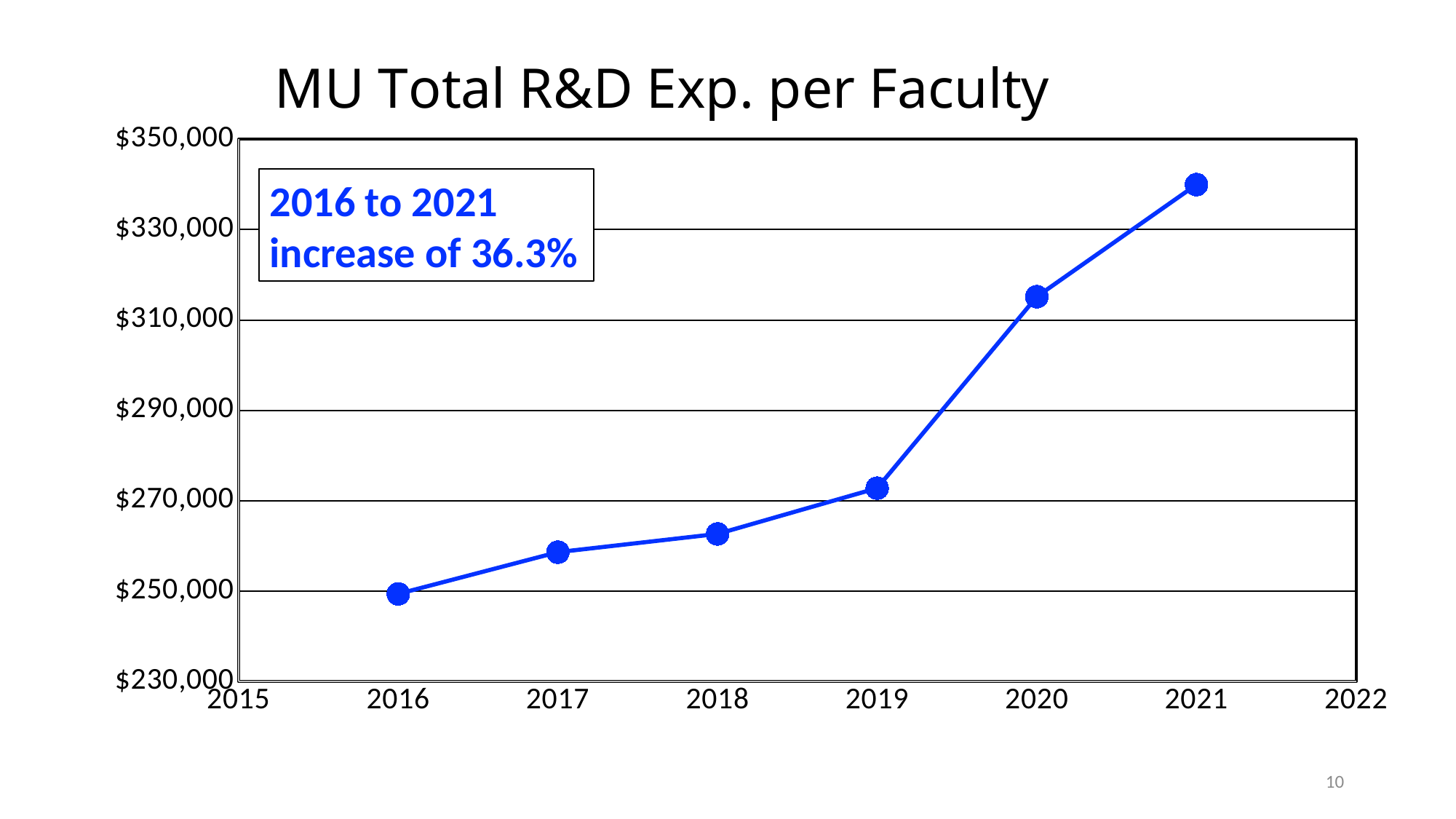
How many data points are plotted on the line? 6 Is the value for 2020 greater or less than $310,000? greater According to the annotation on the chart, what is the percentage increase from 2016 to 2021? 36.3% What is the title of the chart? MU Total R&D Exp. per Faculty Which is larger, the value for 2019 or the value for 2020? 2020 Which year has the lowest value? 2016 Is the value for 2019 greater or less than $290,000? less What kind of chart is shown on the slide? line chart Do the values rise or fall from 2016 to 2021? rise Is the value for 2018 greater or less than $270,000? less Which year has the highest value? 2021